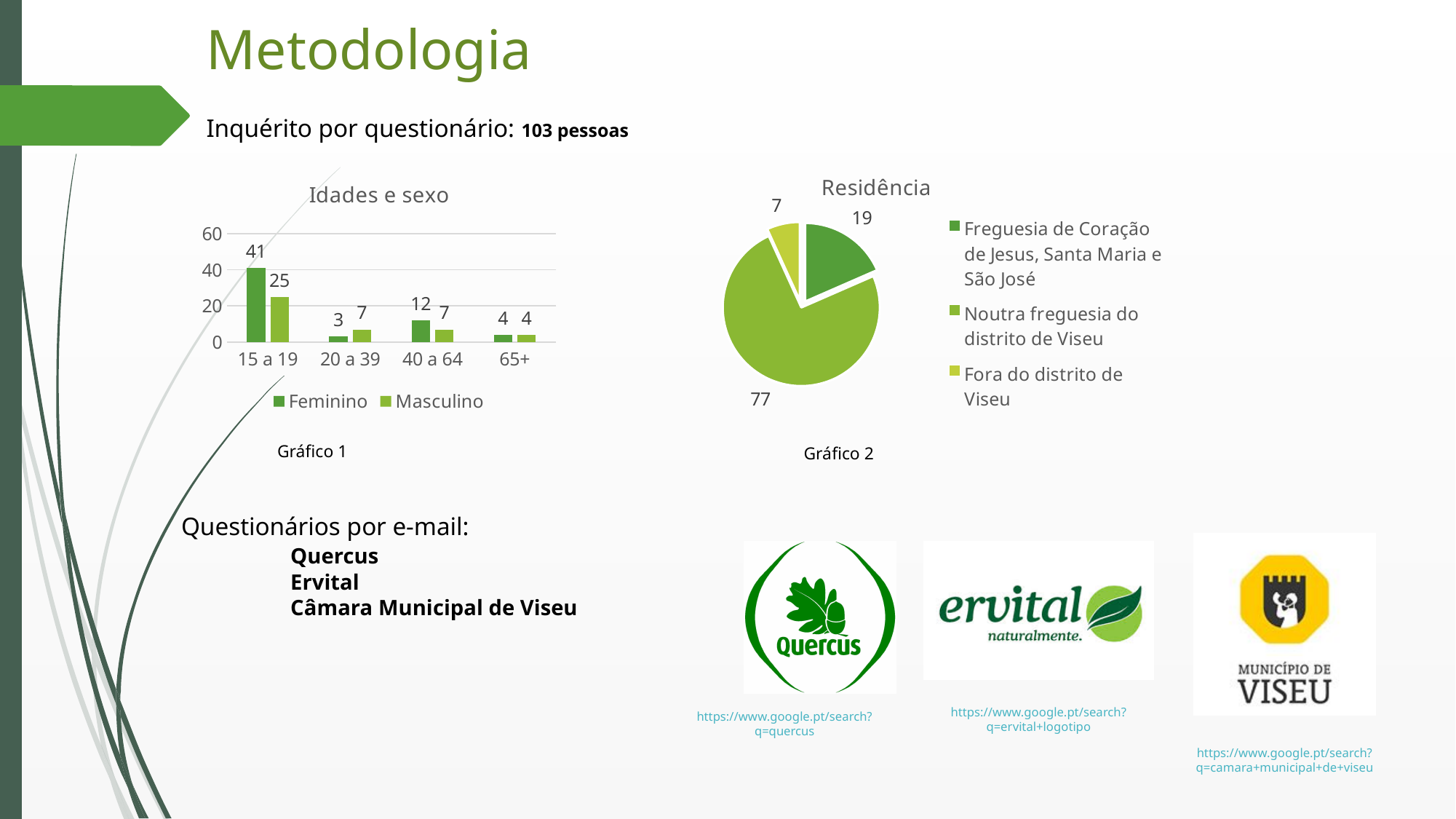
In the 'Idades e sexo' chart, how many age groups are shown on the x axis? 4 In the 'Residência' chart, which category has the smallest slice? Fora do distrito de Viseu In the 'Idades e sexo' chart, how many series does the legend list? 2 In the 'Idades e sexo' chart, what is the difference between the Feminino and Masculino values for the 15 a 19 age group? 16 In the 'Idades e sexo' chart, which age group has the highest Feminino value? 15 a 19 What kind of chart is 'Residência'? Pie chart In the 'Idades e sexo' chart, which age group has the lowest Feminino value? 20 a 39 In the 'Idades e sexo' chart, which is larger for the 20 a 39 age group, Feminino or Masculino? Masculino What kind of chart is 'Idades e sexo'? Bar chart In the 'Idades e sexo' chart, what is the Masculino value for the 40 a 64 age group? 7 In the 'Idades e sexo' chart, what is the Feminino value for the 15 a 19 age group? 41 In the 'Residência' chart, what is the value for 'Noutra freguesia do distrito de Viseu'? 77